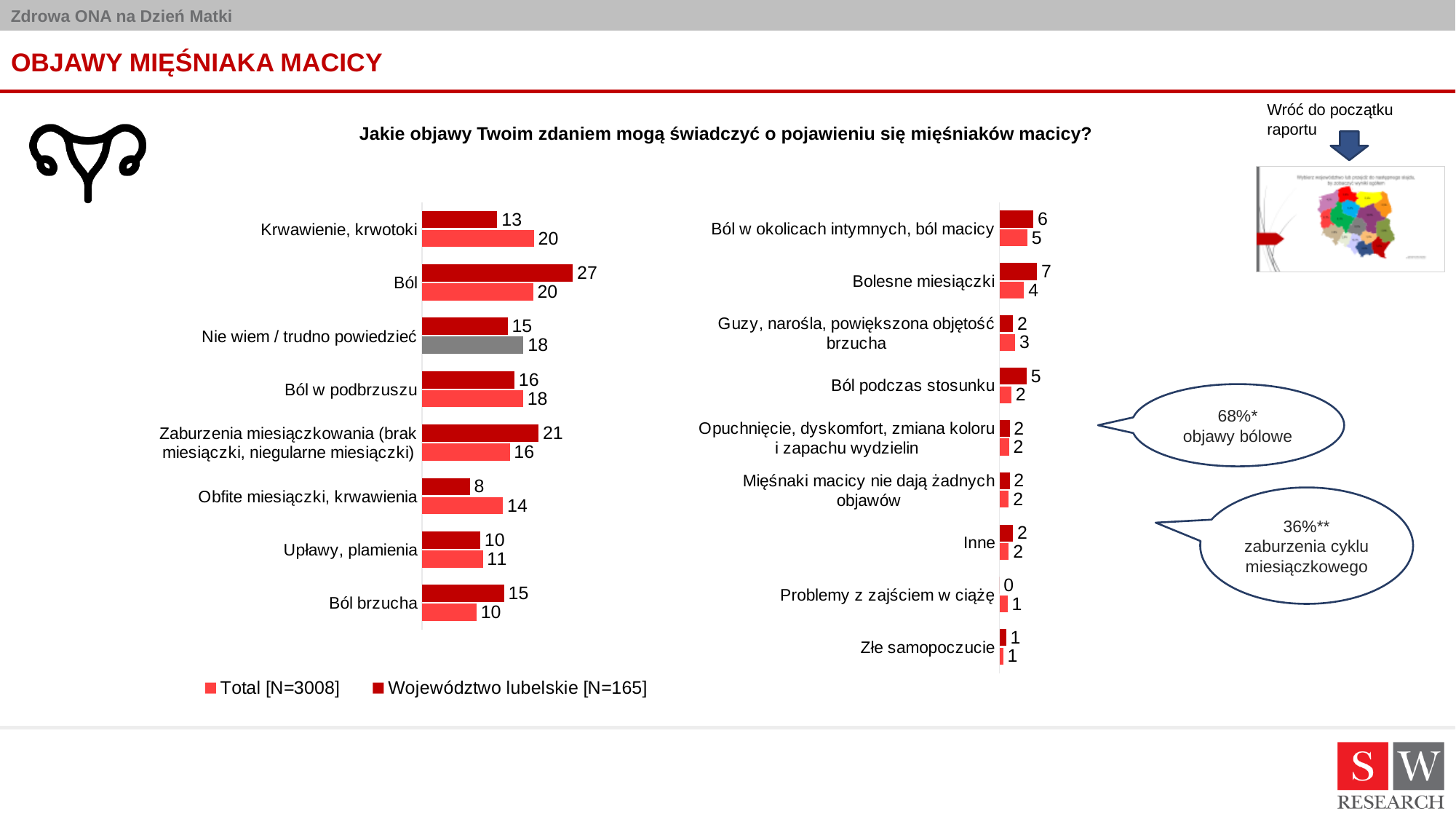
What type of chart is the right chart? Bar chart On the left chart, what is the Total [N=3008] value for Krwawienie, krwotoki? 20 On the left chart, which is larger for Zaburzenia miesiączkowania: the Total [N=3008] value or the Województwo lubelskie [N=165] value? Województwo lubelskie [N=165] How many categories are shown on the left chart? 8 On the left chart, what is the Województwo lubelskie [N=165] value for Ból? 27 How many series does the legend list? 2 On the left chart, which category has the lowest Total [N=3008] value? Ból brzucha On the right chart, what is the Total [N=3008] value for Problemy z zajściem w ciążę? 1 On the left chart, what is the difference between the Województwo lubelskie [N=165] and Total [N=3008] values for Obfite miesiączki, krwawienia? 6 On the left chart, which category has the highest Województwo lubelskie [N=165] value? Ból On the right chart, which category has the highest Total [N=3008] value? Ból w okolicach intymnych, ból macicy On the right chart, what is the Województwo lubelskie [N=165] value for Bolesne miesiączki? 7